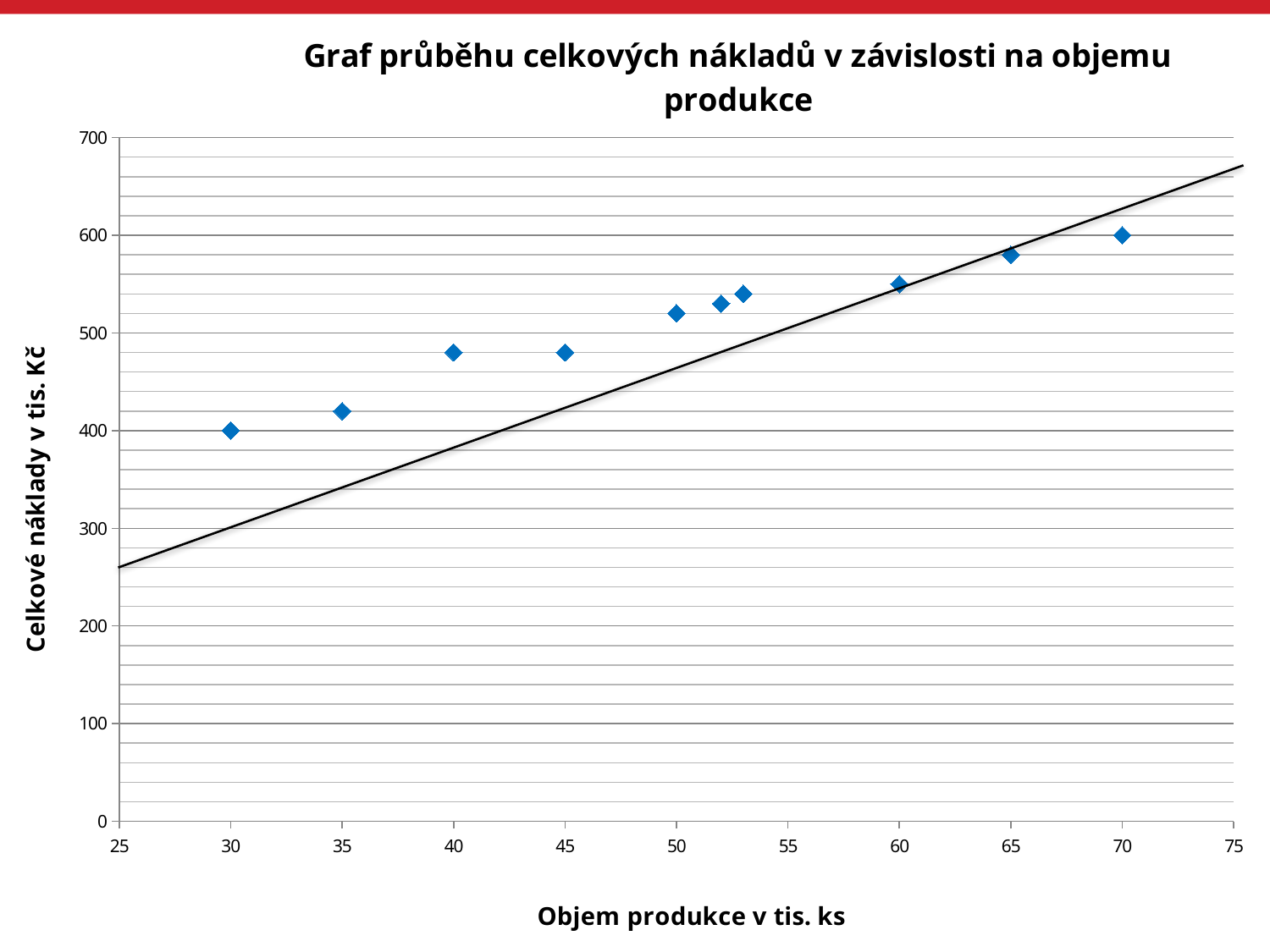
How many data points are plotted on the chart? 10 Is the total cost at a production volume of 40 tis. ks greater or less than 400? greater Which has the higher total cost: a production volume of 40 tis. ks or 60 tis. ks? 60 Is the total cost at a production volume of 35 tis. ks greater or less than 500? less What is the total cost value (Celkové náklady) at a production volume of 30 tis. ks? 400 What is the total cost value (Celkové náklady) at a production volume of 70 tis. ks? 600 At which production volume (Objem produkce) is the total cost lowest? 30 At which production volume (Objem produkce) is the total cost highest? 70 Is the total cost at a production volume of 60 tis. ks greater or less than 500? greater What is the label of the vertical axis? Celkové náklady v tis. Kč What kind of chart is shown on the slide? scatter chart Do the total costs rise or fall as the production volume increases along the x axis? rise